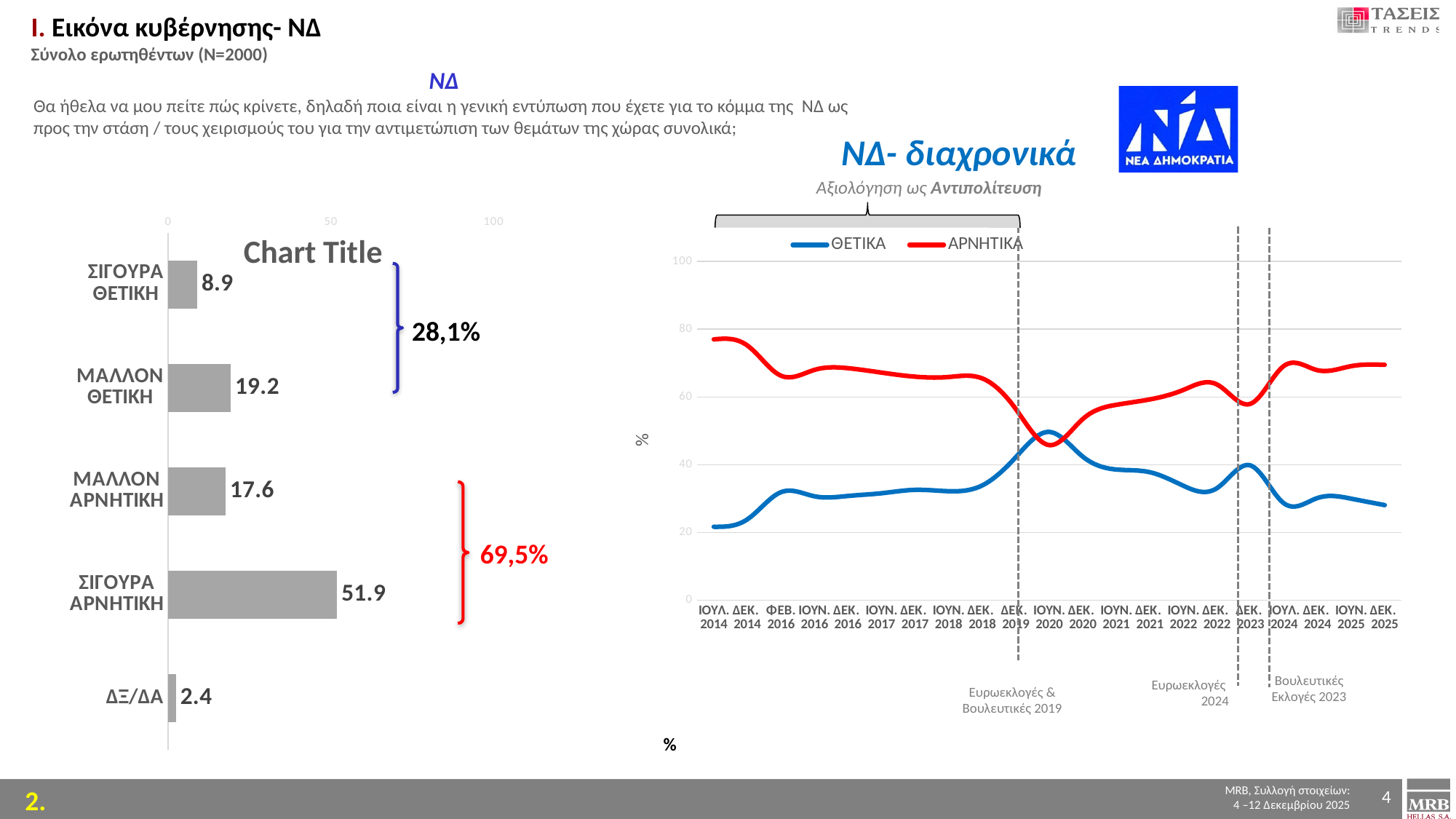
In the 'ΝΔ- διαχρονικά' chart, is the value of ΑΡΝΗΤΙΚΑ at ΙΟΥΛ. 2014 greater or less than 60? greater What kind of chart is the chart on the left? bar chart In the bar chart on the left, what is the value for ΜΑΛΛΟΝ ΘΕΤΙΚΗ? 19.2 In the bar chart on the left, what is the value for ΔΞ/ΔΑ? 2.4 In the bar chart on the left, which category has the highest value? ΣΙΓΟΥΡΑ ΑΡΝΗΤΙΚΗ In the bar chart on the left, what is the difference between ΣΙΓΟΥΡΑ ΑΡΝΗΤΙΚΗ and ΜΑΛΛΟΝ ΑΡΝΗΤΙΚΗ? 34.3 In the bar chart on the left, which is larger: ΜΑΛΛΟΝ ΘΕΤΙΚΗ or ΜΑΛΛΟΝ ΑΡΝΗΤΙΚΗ? ΜΑΛΛΟΝ ΘΕΤΙΚΗ How many series does the legend of the 'ΝΔ- διαχρονικά' chart list? 2 How many categories does the bar chart on the left show? 5 In the 'ΝΔ- διαχρονικά' chart, which colour is the ΘΕΤΙΚΑ line? blue In the bar chart on the left, what is the value for ΣΙΓΟΥΡΑ ΑΡΝΗΤΙΚΗ? 51.9 In the bar chart on the left, which category has the lowest value? ΔΞ/ΔΑ